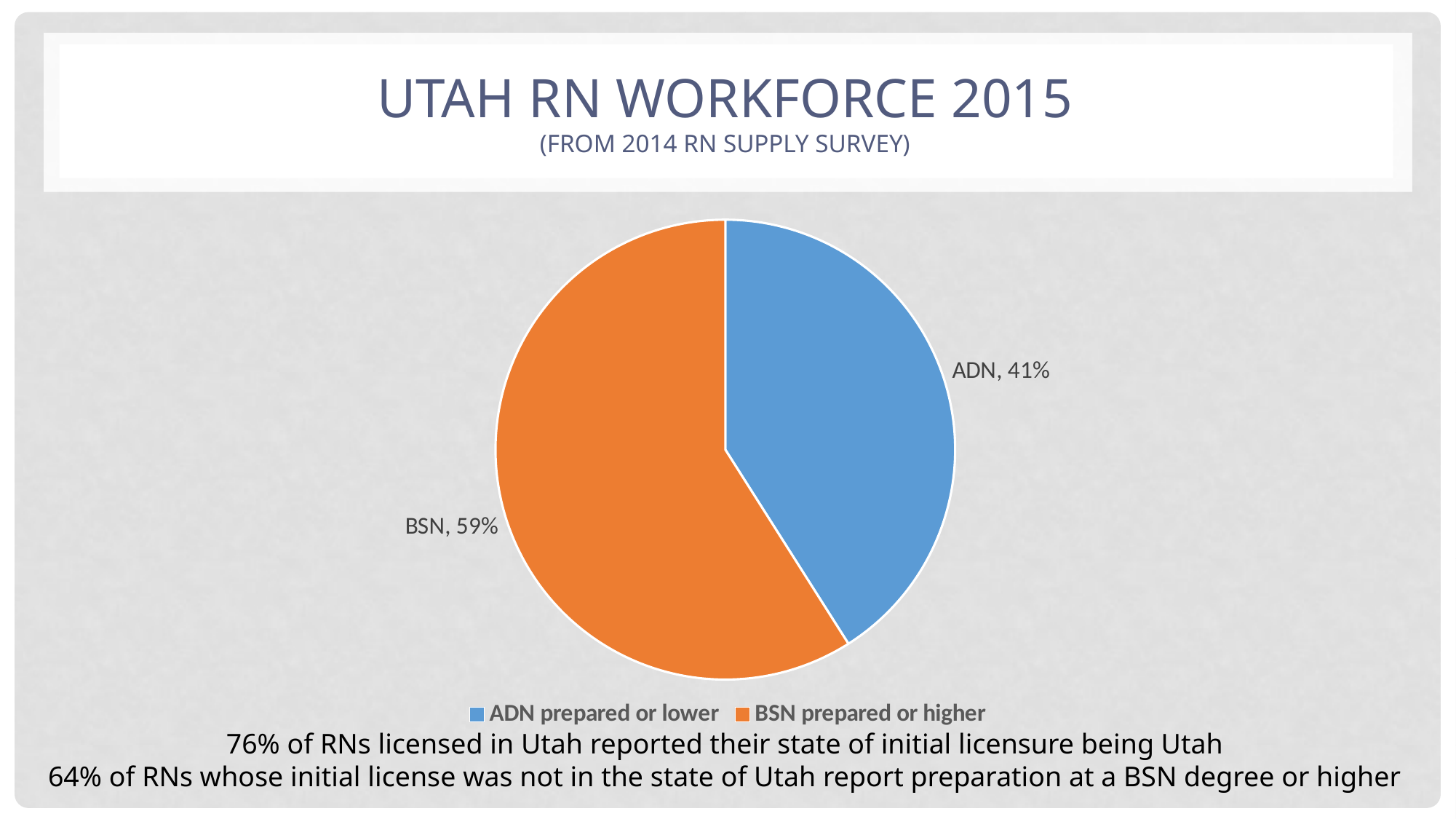
What is the difference in percentage points between the BSN slice and the ADN slice? 18 What percentage of the pie is labelled ADN? 41% Which slice of the pie is the smallest? ADN Which slice of the pie is the largest? BSN What percentage of the pie is labelled BSN? 59% How many slices does the pie chart have? 2 What is the full legend label for the orange slice? BSN prepared or higher What colour is the slice for ADN prepared or lower? blue What kind of chart is shown on the slide? pie chart How many entries does the legend list? 2 Which is larger, the ADN slice or the BSN slice? BSN What share of the pie does the BSN slice represent? 59%